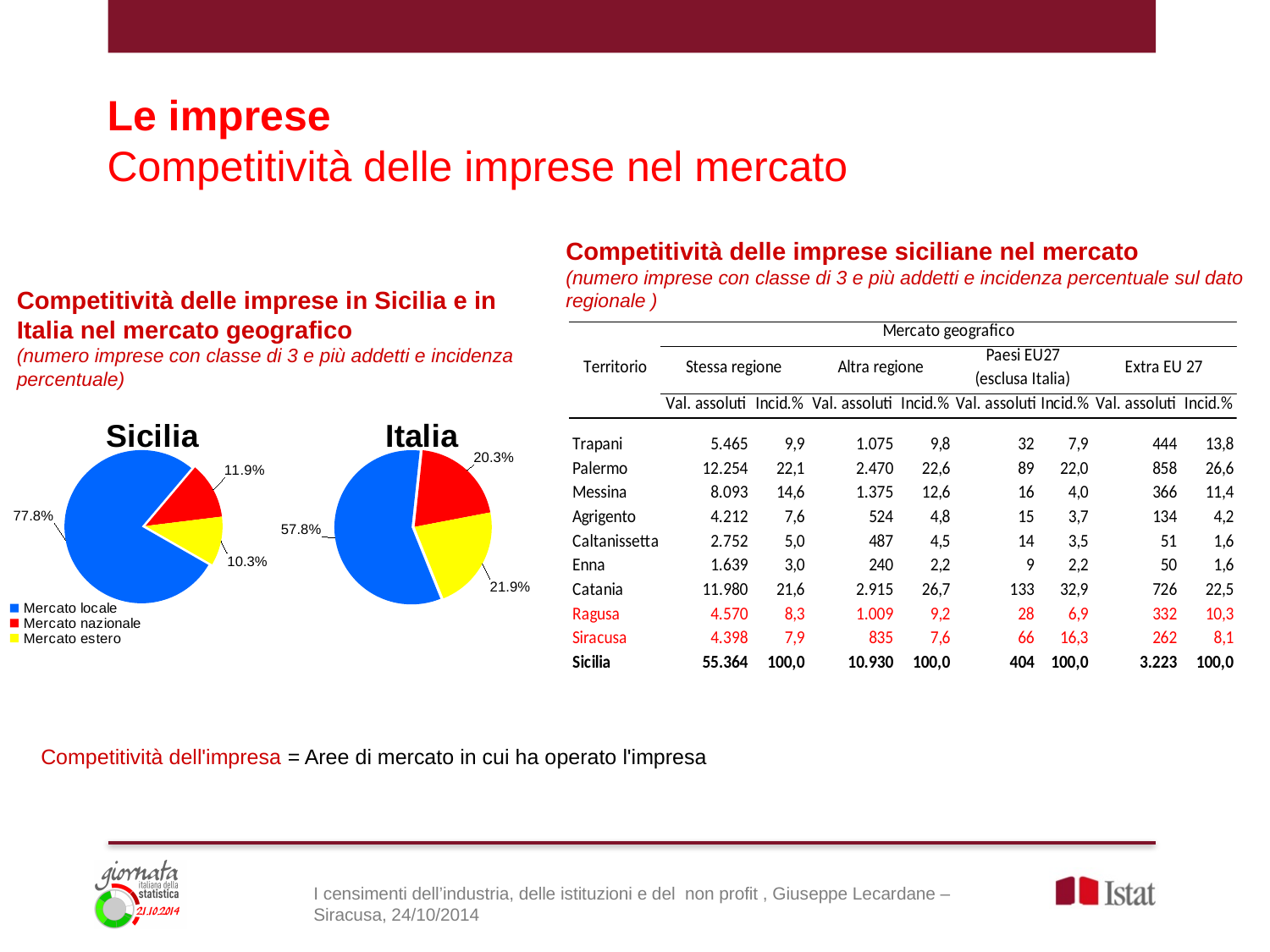
What is the difference between the Mercato locale share in the Sicilia pie chart and in the Italia pie chart? 20.0 percentage points How many slices does the Sicilia pie chart have? 3 In the Sicilia pie chart, which category has the smallest slice? Mercato estero In the Sicilia pie chart, what is the share for Mercato locale? 77.8% Is the Mercato nazionale share larger in the Sicilia pie chart or in the Italia pie chart? Italia What kind of chart is used for Sicilia and Italia? Pie chart In the Italia pie chart, which category has the largest slice? Mercato locale In the pie charts, which colour represents Mercato estero? Yellow In the Sicilia pie chart, what is the share for Mercato nazionale? 11.9% In the Italia pie chart, what is the share for Mercato locale? 57.8% How many entries does the legend of the pie charts list? 3 In the Italia pie chart, what is the share for Mercato estero? 21.9%